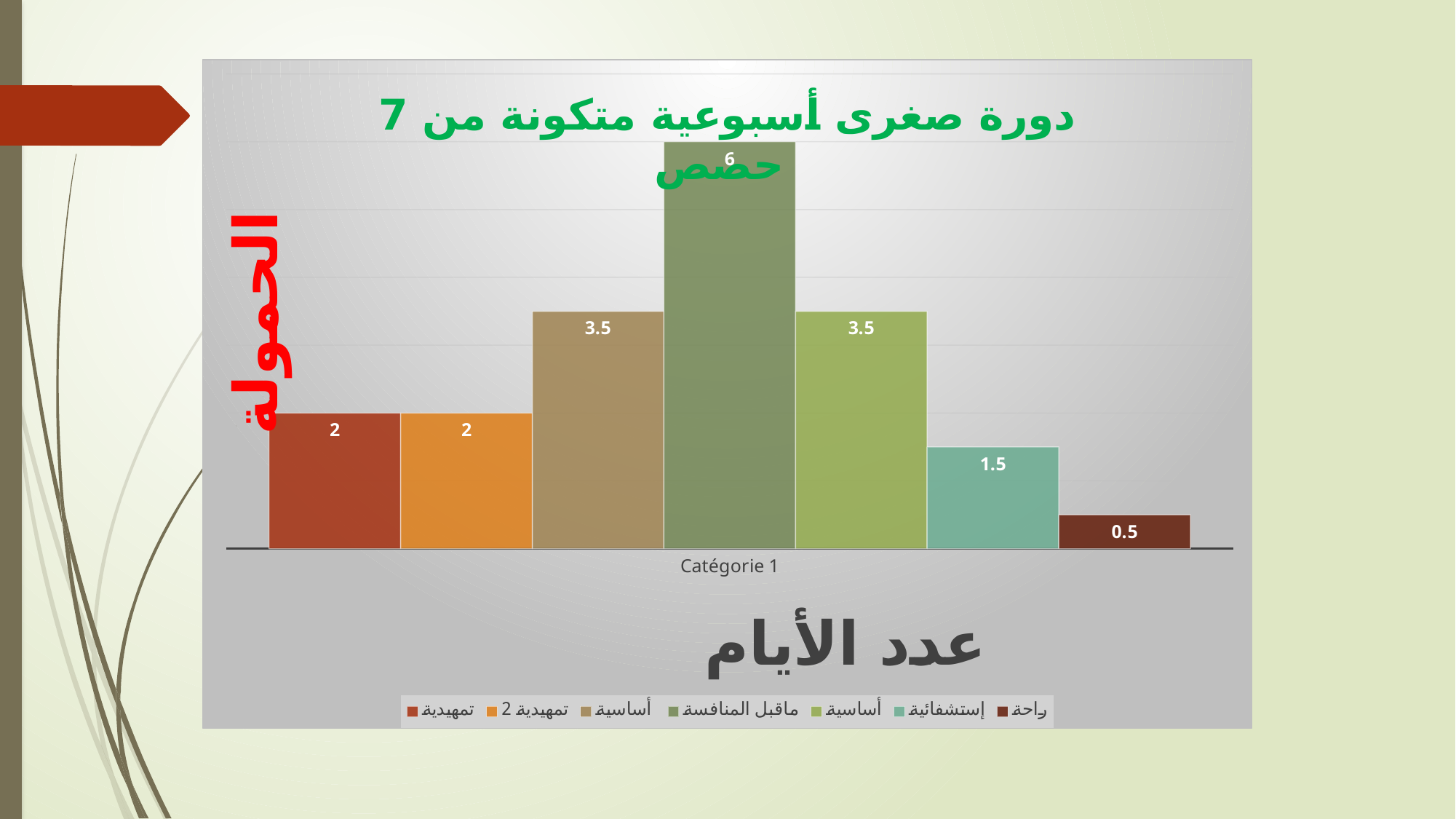
What kind of chart is shown on the slide? bar chart What is the category label shown on the x axis? Catégorie 1 Which series has the highest bar? ماقبل المنافسة What is the title of the chart? دورة صغرى أسبوعية متكونة من 7 حصص What is the value of the ماقبل المنافسة bar? 6 What is the value of the راحة bar? 0.5 What is the difference between the ماقبل المنافسة bar and the إستشفائية bar? 4.5 Which series has the lowest bar? راحة How many series does the legend list? 7 What is the value of the إستشفائية bar? 1.5 Which is larger, the تمهيدية bar or the إستشفائية bar? تمهيدية What is the value of the تمهيدية 2 bar? 2